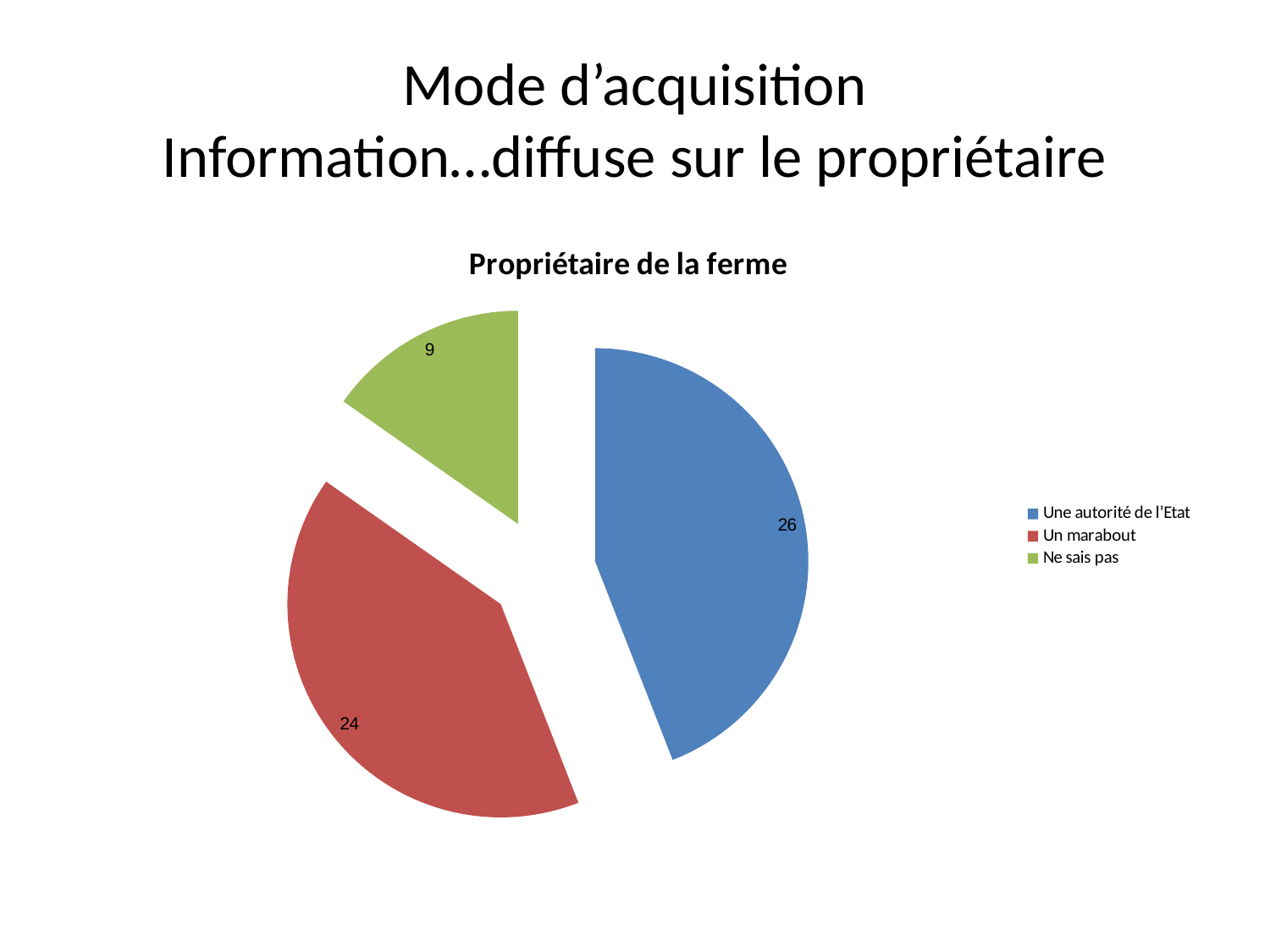
What is the total of all the slices in the pie chart? 59 What is the difference between the values for Un marabout and Ne sais pas? 15 Which is larger, the value for Un marabout or the value for Ne sais pas? Un marabout What is the value for Ne sais pas? 9 What type of chart is shown on the slide? pie chart What is the difference between the values for Une autorité de l'Etat and Un marabout? 2 What is the value for Une autorité de l'Etat? 26 What is the title of the chart? Propriétaire de la ferme What is the value for Un marabout? 24 Which category has the largest slice? Une autorité de l'Etat How many slices does the pie chart have? 3 Which category has the smallest slice? Ne sais pas